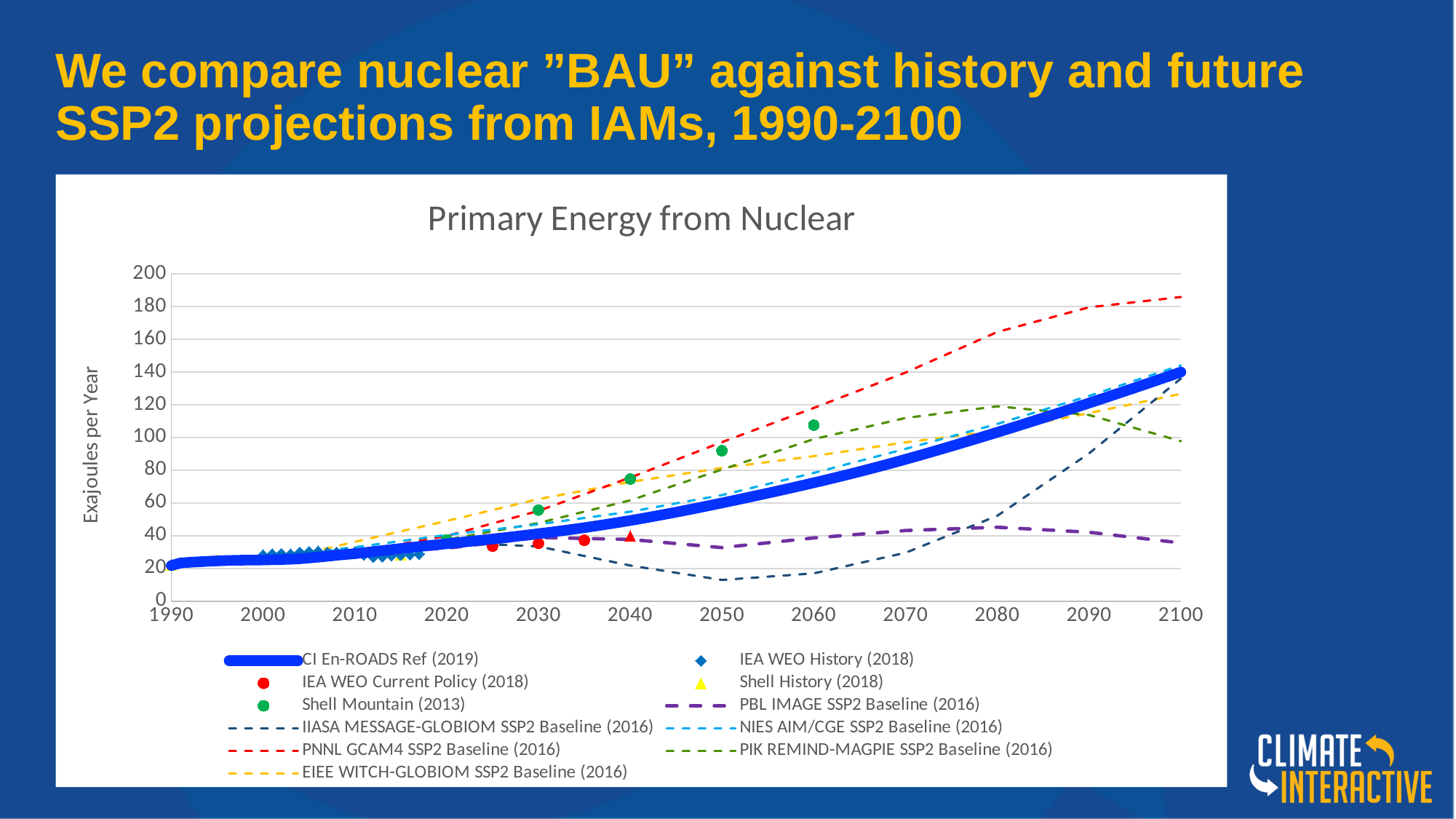
Does the CI En-ROADS Ref (2019) series rise or fall from 1990 to 2100? rise What is the label on the vertical axis of the chart? Exajoules per Year Is the value of the PNNL GCAM4 SSP2 Baseline (2016) series at 2100 greater or less than 160? greater Is the Shell Mountain (2013) point at 2060 greater or less than 100? greater At 2100, which is larger: the PNNL GCAM4 SSP2 Baseline (2016) series or the PBL IMAGE SSP2 Baseline (2016) series? PNNL GCAM4 SSP2 Baseline (2016) Is the value of the CI En-ROADS Ref (2019) series at 2100 greater or less than 120? greater What is the title of the chart? Primary Energy from Nuclear Which series has the lowest value at 2100? PBL IMAGE SSP2 Baseline (2016) What kind of chart is shown on the slide? line chart Which series has the highest value at 2100? PNNL GCAM4 SSP2 Baseline (2016) How many series does the chart legend list? 11